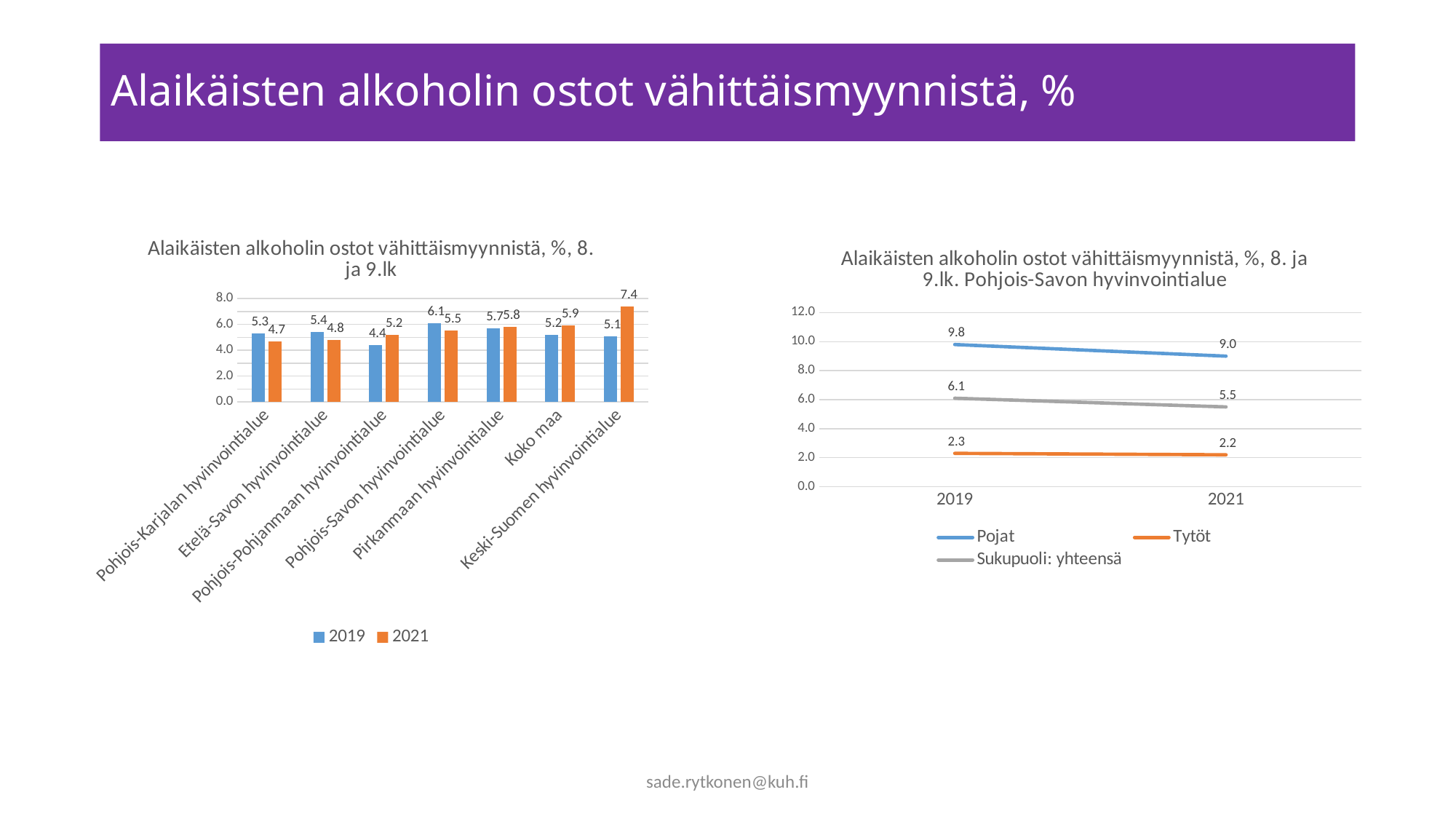
How many categories are shown on the x axis of the left chart? 7 In the left chart, what is the 2019 value for Pohjois-Savon hyvinvointialue? 6.1 In the left chart, which category has the highest 2021 value? Keski-Suomen hyvinvointialue In the right chart, what is the value for Pojat in 2019? 9.8 In the left chart, what is the 2021 value for Keski-Suomen hyvinvointialue? 7.4 In the right chart, does the Sukupuoli: yhteensä line rise or fall from 2019 to 2021? fall In the right chart, what is the difference between the Pojat and Tytöt values in 2021? 6.8 In the left chart, which category has the lowest 2019 value? Pohjois-Pohjanmaan hyvinvointialue How many series does the legend of the left chart list? 2 What type of chart is the chart on the right of the slide? line chart In the left chart, what is the difference between the 2021 and 2019 values for Keski-Suomen hyvinvointialue? 2.3 In the left chart, is the 2019 value for Koko maa larger or smaller than its 2021 value? smaller